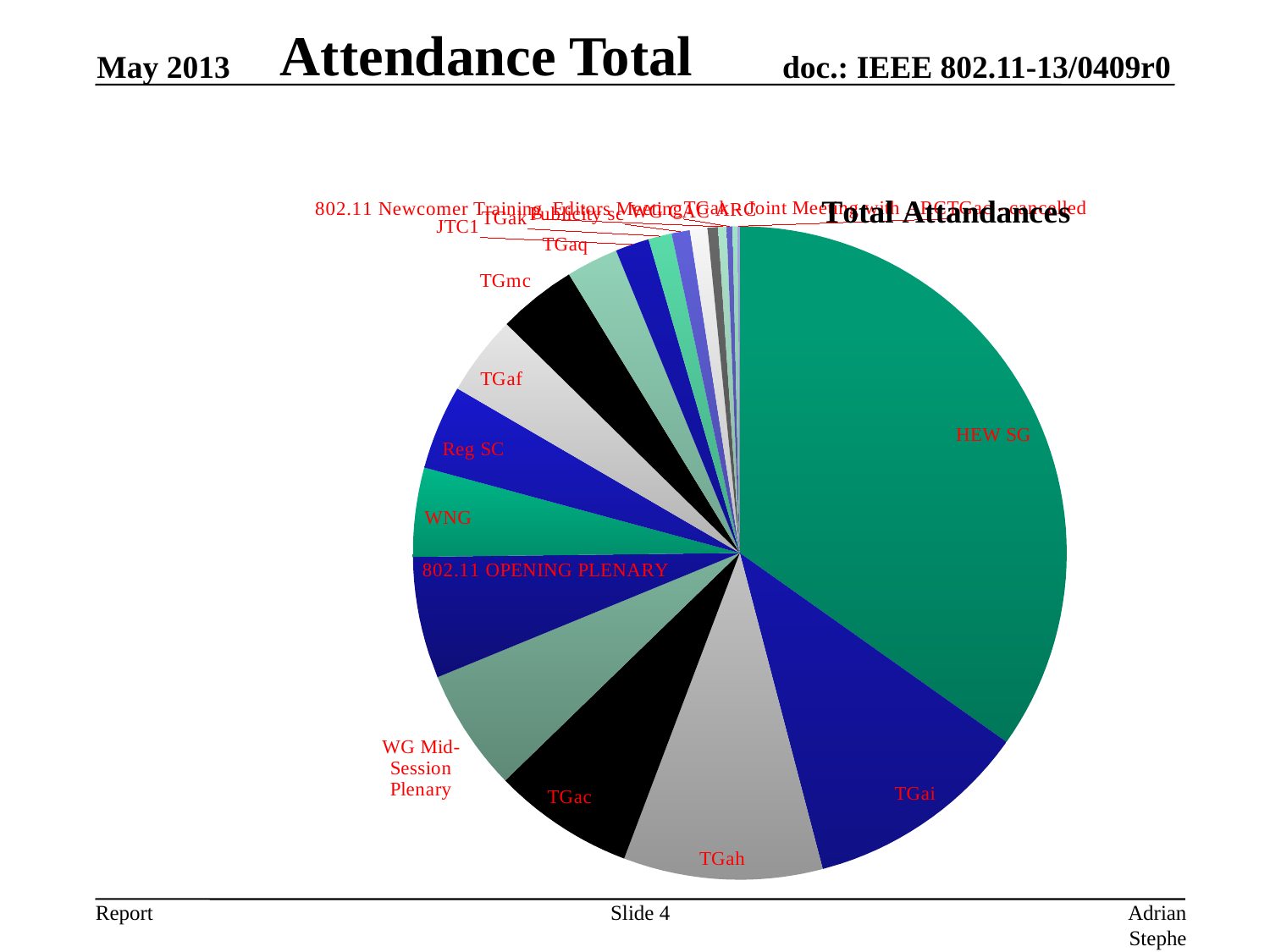
Which slice is larger, TGah or TGac? TGah Which category has the largest slice of the pie? HEW SG Which slice is larger, TGah or WG Mid-Session Plenary? TGah Which slice is larger, Reg SC or TGaq? Reg SC What kind of chart is shown on the slide? pie chart What is the title of the chart? Total Attandances What colour is the HEW SG slice? green